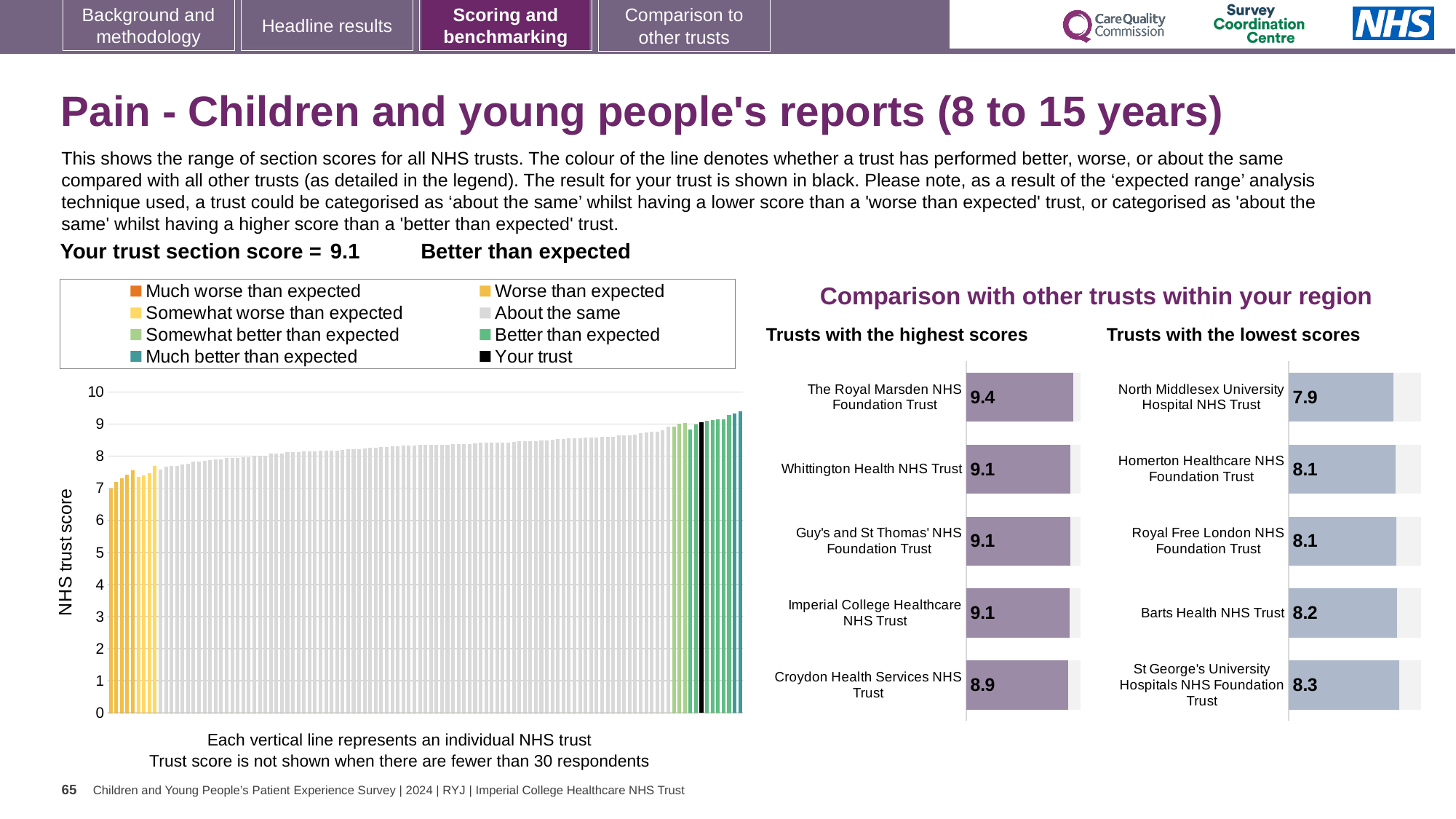
In the 'Trusts with the lowest scores' chart, what is the score for North Middlesex University Hospital NHS Trust? 7.9 In the 'Trusts with the lowest scores' chart, what is the score for Barts Health NHS Trust? 8.2 In the 'Trusts with the highest scores' chart, what is the score for The Royal Marsden NHS Foundation Trust? 9.4 In the 'Trusts with the lowest scores' chart, which trust has the lowest score? North Middlesex University Hospital NHS Trust In the 'Trusts with the highest scores' chart, which trust has the highest score? The Royal Marsden NHS Foundation Trust How many trusts are shown in the 'Trusts with the highest scores' chart? 5 What is the difference between The Royal Marsden NHS Foundation Trust's score in the highest scores chart and North Middlesex University Hospital NHS Trust's score in the lowest scores chart? 1.5 In the 'Trusts with the highest scores' chart, what is the score for Croydon Health Services NHS Trust? 8.9 In the main NHS trust score chart, what is the section score for your trust (the black bar)? 9.1 In the main NHS trust score chart, is the value of the leftmost (lowest) bar greater or less than 8? less How many entries does the legend of the main NHS trust score chart list? 8 In the 'Trusts with the lowest scores' chart, which has the larger score: Barts Health NHS Trust or St George's University Hospitals NHS Foundation Trust? St George's University Hospitals NHS Foundation Trust